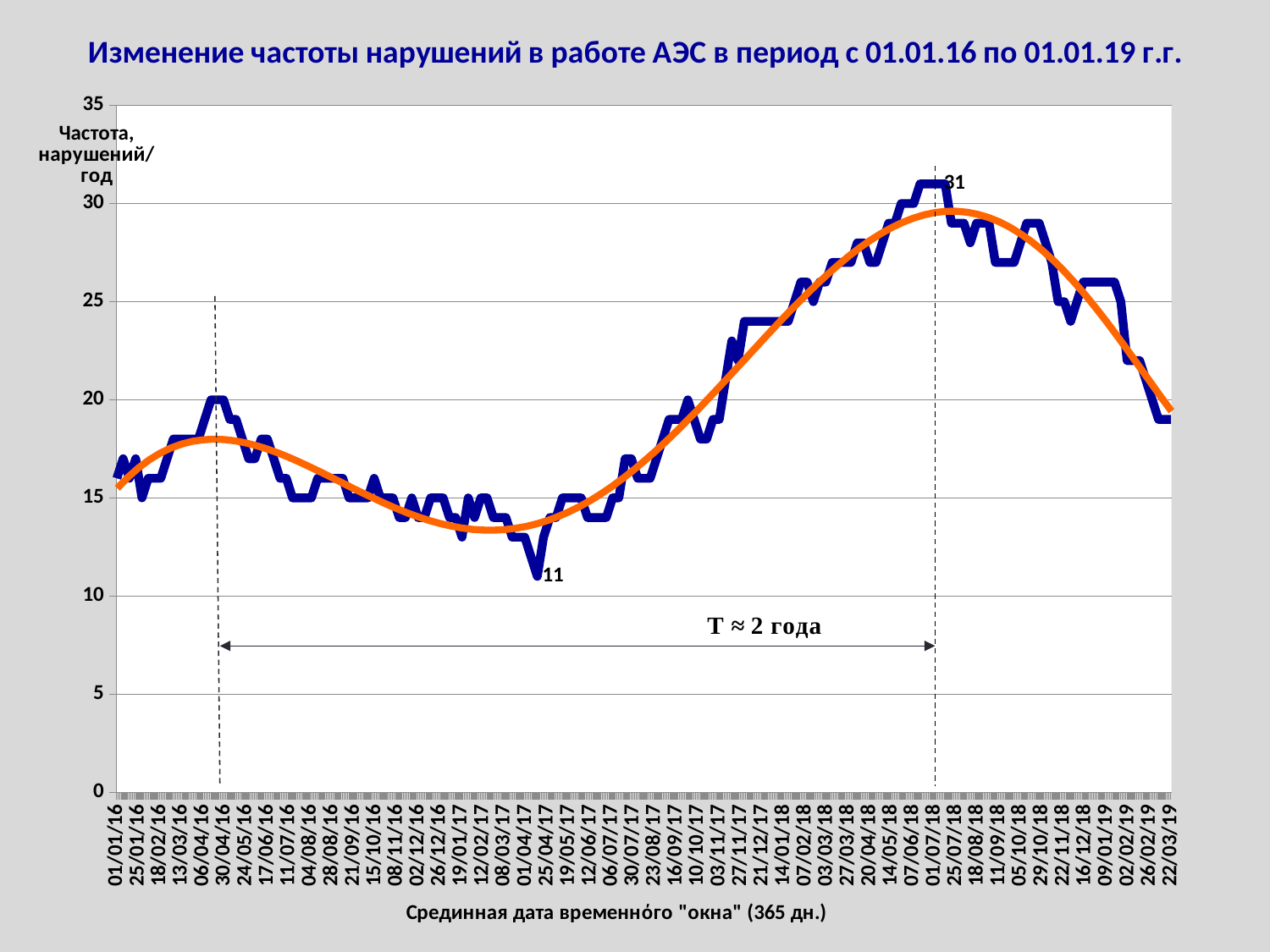
What is the highest value labelled on the chart? 31 Does the frequency rise or fall between 01/07/18 and 22/03/19? fall What is the difference between the labelled maximum (31) and the labelled minimum (11)? 20 How many lines are plotted on the chart? 2 Is the value around 30/04/16 greater or less than 15? greater What is the lowest value labelled on the chart? 11 What period T is indicated by the arrow annotation between the two dashed lines? T ≈ 2 года Which is larger: the peak around 30/04/16 or the peak around 01/07/18? the peak around 01/07/18 Is the value around 01/04/17 greater or less than 15? less What kind of chart is shown on the slide? line chart Does the frequency rise or fall between 01/04/17 and 01/07/18? rise Is the value around 27/11/17 greater or less than 20? greater